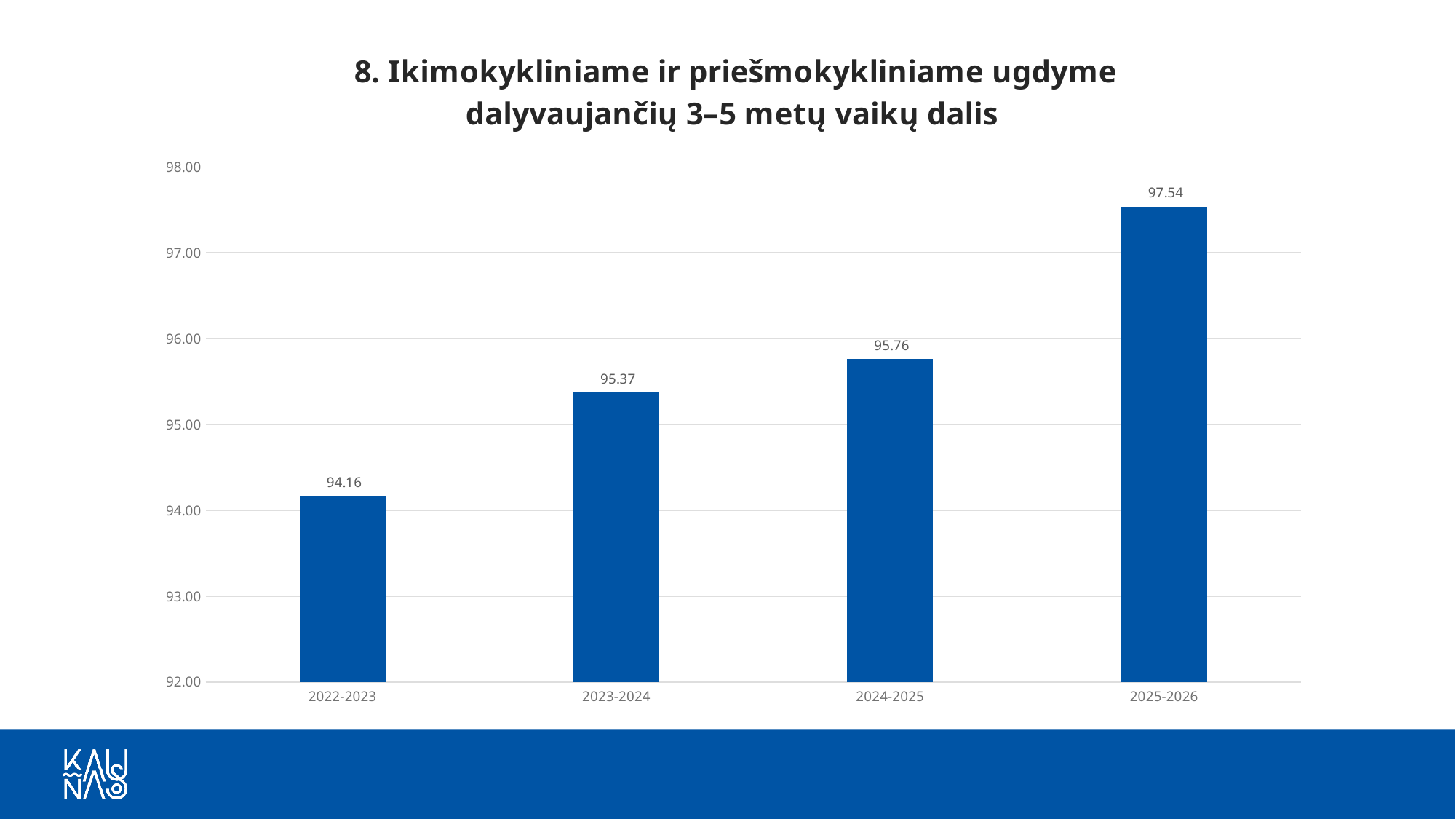
What is the difference between the values for 2025-2026 and 2024-2025? 1.78 What is the value for 2025-2026? 97.54 What is the value for 2024-2025? 95.76 What is the difference between the values for 2023-2024 and 2022-2023? 1.21 Which period has the highest value? 2025-2026 What is the value for 2023-2024? 95.37 Which period has the lowest value? 2022-2023 What kind of chart is shown on the slide? bar chart What is the value for 2022-2023? 94.16 Is the value for 2025-2026 greater or less than 97.00? greater How many periods are shown on the x axis? 4 Which is larger, the value for 2024-2025 or the value for 2023-2024? 2024-2025